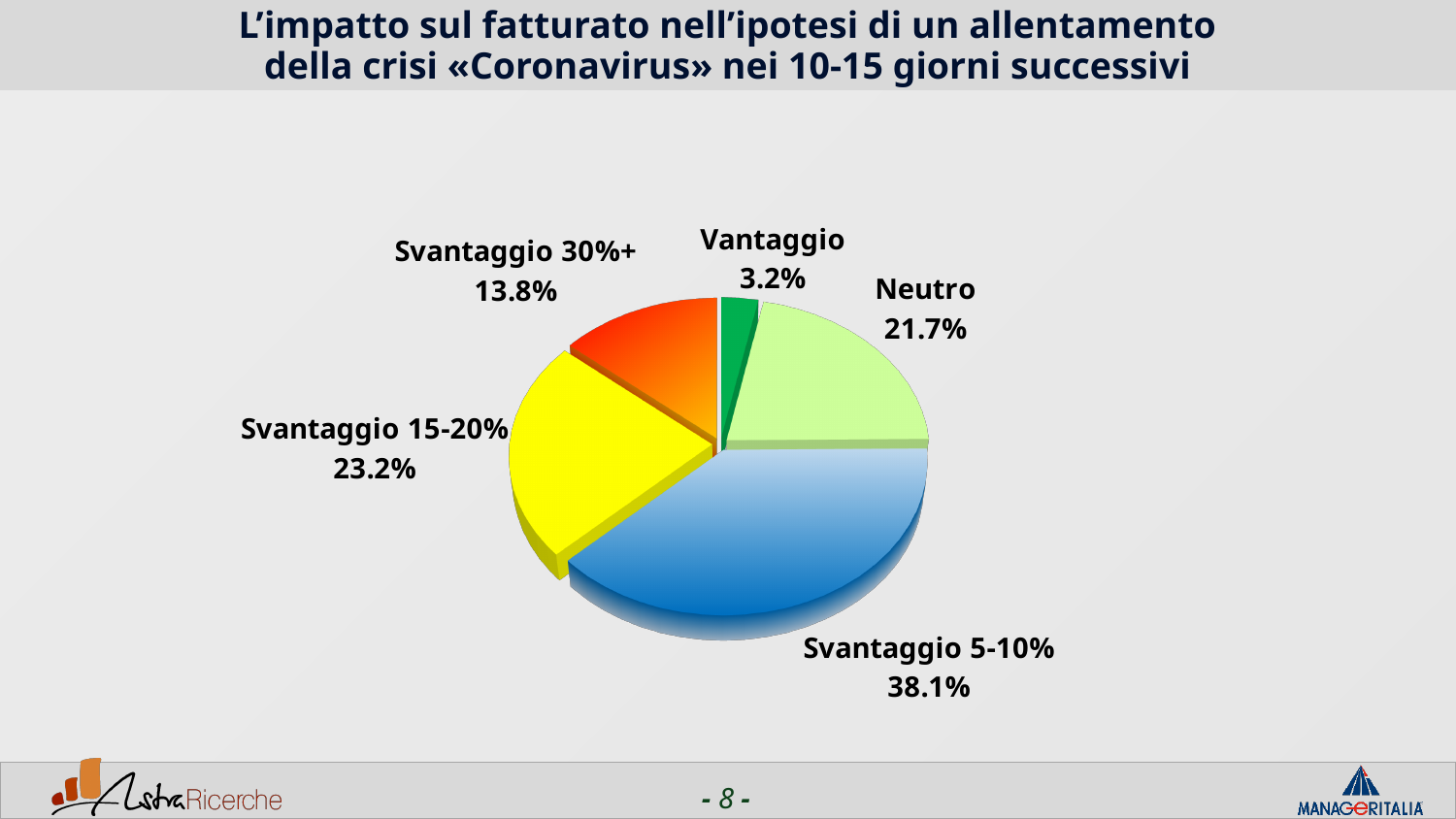
What is the value for Svantaggio 30%+? 13.8% What is the value for Neutro? 21.7% Which category has the largest share of the pie? Svantaggio 5-10% Which is larger, Neutro or Svantaggio 15-20%? Svantaggio 15-20% What is the difference between Neutro and Svantaggio 30%+? 7.9% What is the value for Svantaggio 5-10%? 38.1% What kind of chart is shown on the slide? Pie chart What is the difference between Svantaggio 5-10% and Svantaggio 15-20%? 14.9% What is the value for Vantaggio? 3.2% How many slices does the pie chart have? 5 Which category has the smallest share of the pie? Vantaggio What colour is the Svantaggio 15-20% slice? Yellow